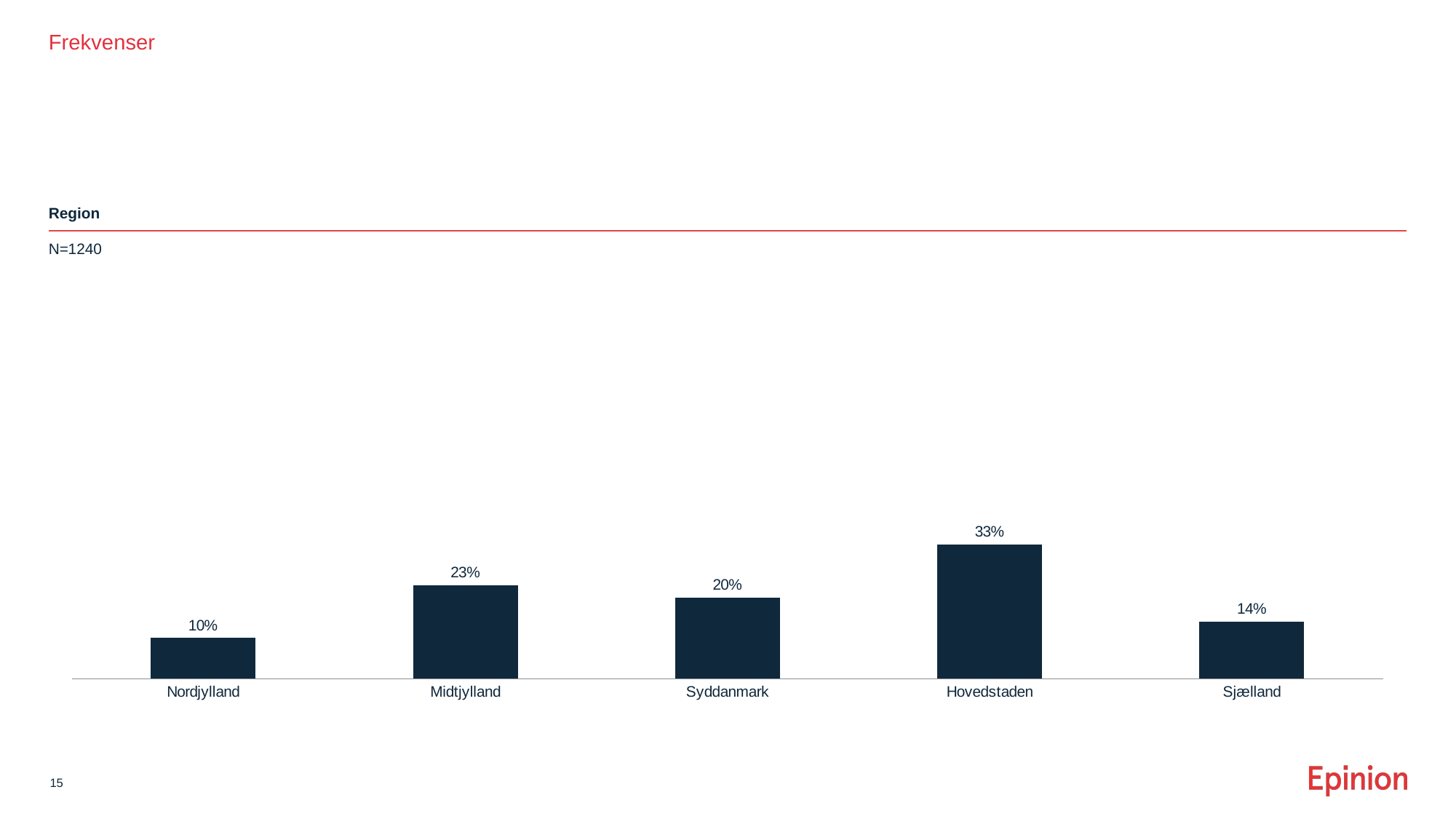
What is the sample size (N) stated for the chart? N=1240 What is the value for Nordjylland? 10% What is the difference between the values for Syddanmark and Nordjylland? 10% What kind of chart is shown on the slide? Bar chart Which region has the highest value? Hovedstaden Which is larger, the value for Midtjylland or the value for Syddanmark? Midtjylland What is the difference between the values for Hovedstaden and Midtjylland? 10% What is the heading above the chart? Region What is the value for Hovedstaden? 33% Which region has the lowest value? Nordjylland What is the value for Sjælland? 14% How many regions are shown in the chart? 5